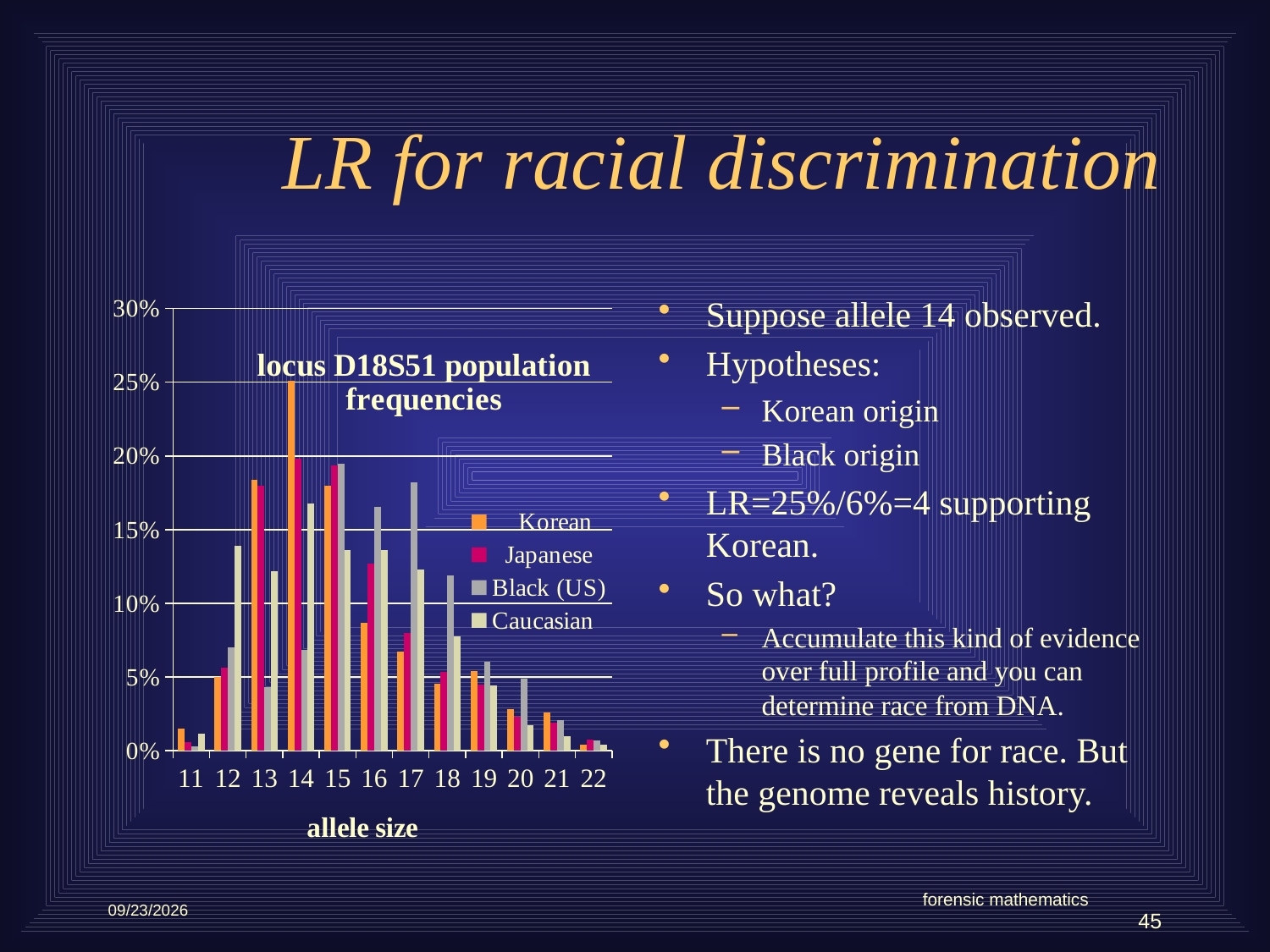
What is the title of the chart? locus D18S51 population frequencies How many allele sizes are shown along the x axis of the chart? 12 How many series does the chart legend list? 4 Is the Korean value for allele size 13 greater or less than 15%? greater Is the Korean value for allele size 16 greater or less than 10%? less Is the Black (US) value for allele size 17 greater or less than 15%? greater At which allele size is the Korean frequency highest? 14 At allele size 14, which is larger, the Korean value or the Japanese value? Korean What is the label of the x axis of the chart? allele size What kind of chart is shown on the slide? bar chart